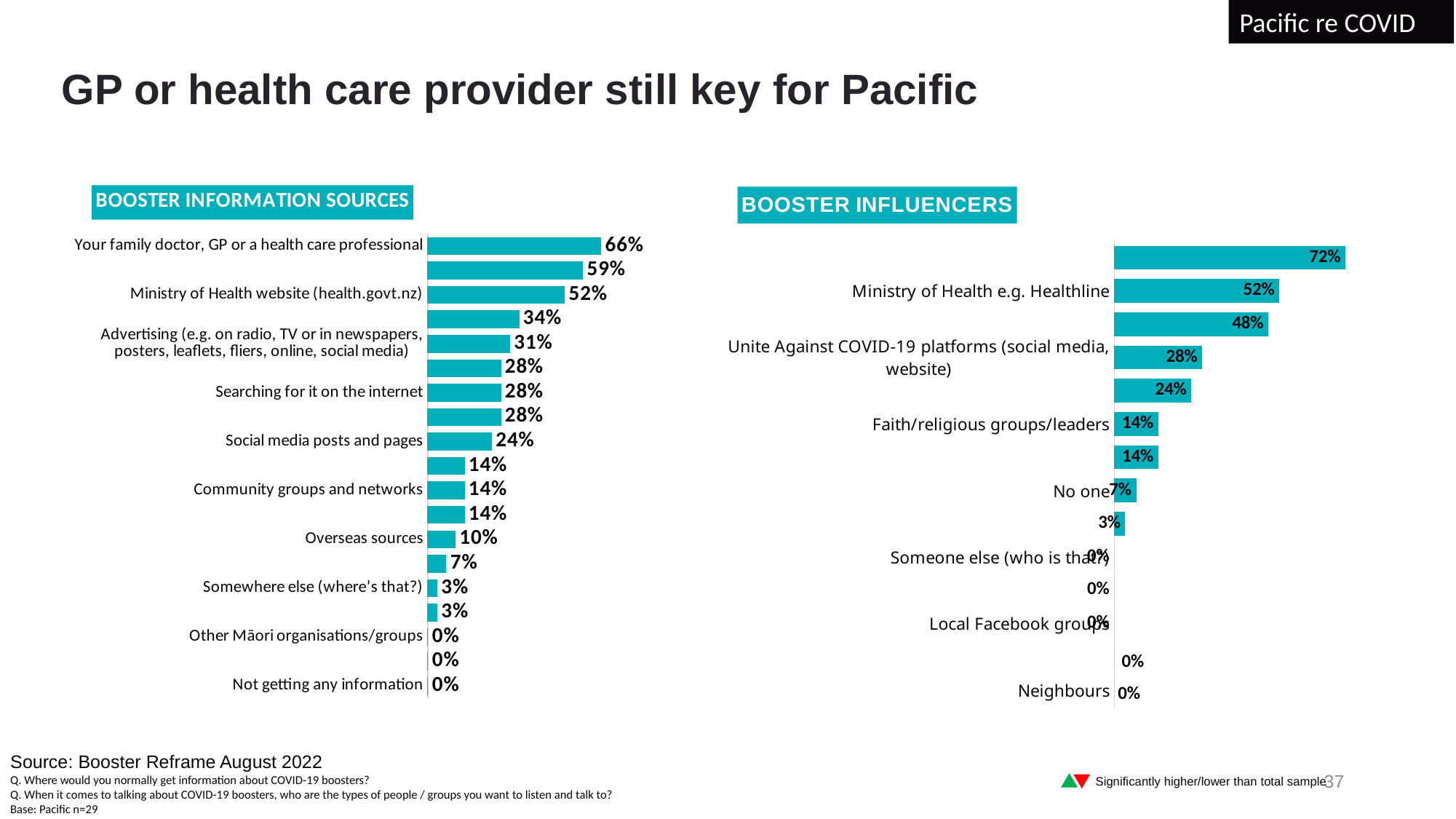
In the BOOSTER INFLUENCERS chart, what is the difference between 'Ministry of Health e.g. Healthline' and 'Unite Against COVID-19 platforms (social media, website)'? 24 percentage points In the BOOSTER INFLUENCERS chart, which is larger: 'Ministry of Health e.g. Healthline' or 'Unite Against COVID-19 platforms (social media, website)'? Ministry of Health e.g. Healthline In the BOOSTER INFORMATION SOURCES chart, what is the difference between 'Your family doctor, GP or a health care professional' and 'Ministry of Health website (health.govt.nz)'? 14 percentage points What type of chart is the BOOSTER INFLUENCERS chart? Bar chart In the BOOSTER INFLUENCERS chart, what is the value for 'Faith/religious groups/leaders'? 14% In the BOOSTER INFORMATION SOURCES chart, what percentage is shown for 'Your family doctor, GP or a health care professional'? 66% In the BOOSTER INFORMATION SOURCES chart, what is the value for 'Social media posts and pages'? 24% In the BOOSTER INFLUENCERS chart, what is the value for 'No one'? 7% In the BOOSTER INFORMATION SOURCES chart, which category has the highest value? Your family doctor, GP or a health care professional In the BOOSTER INFLUENCERS chart, what is the value for 'Ministry of Health e.g. Healthline'? 52% In the BOOSTER INFORMATION SOURCES chart, what is the value for 'Overseas sources'? 10% In the BOOSTER INFORMATION SOURCES chart, what is the value for 'Ministry of Health website (health.govt.nz)'? 52%